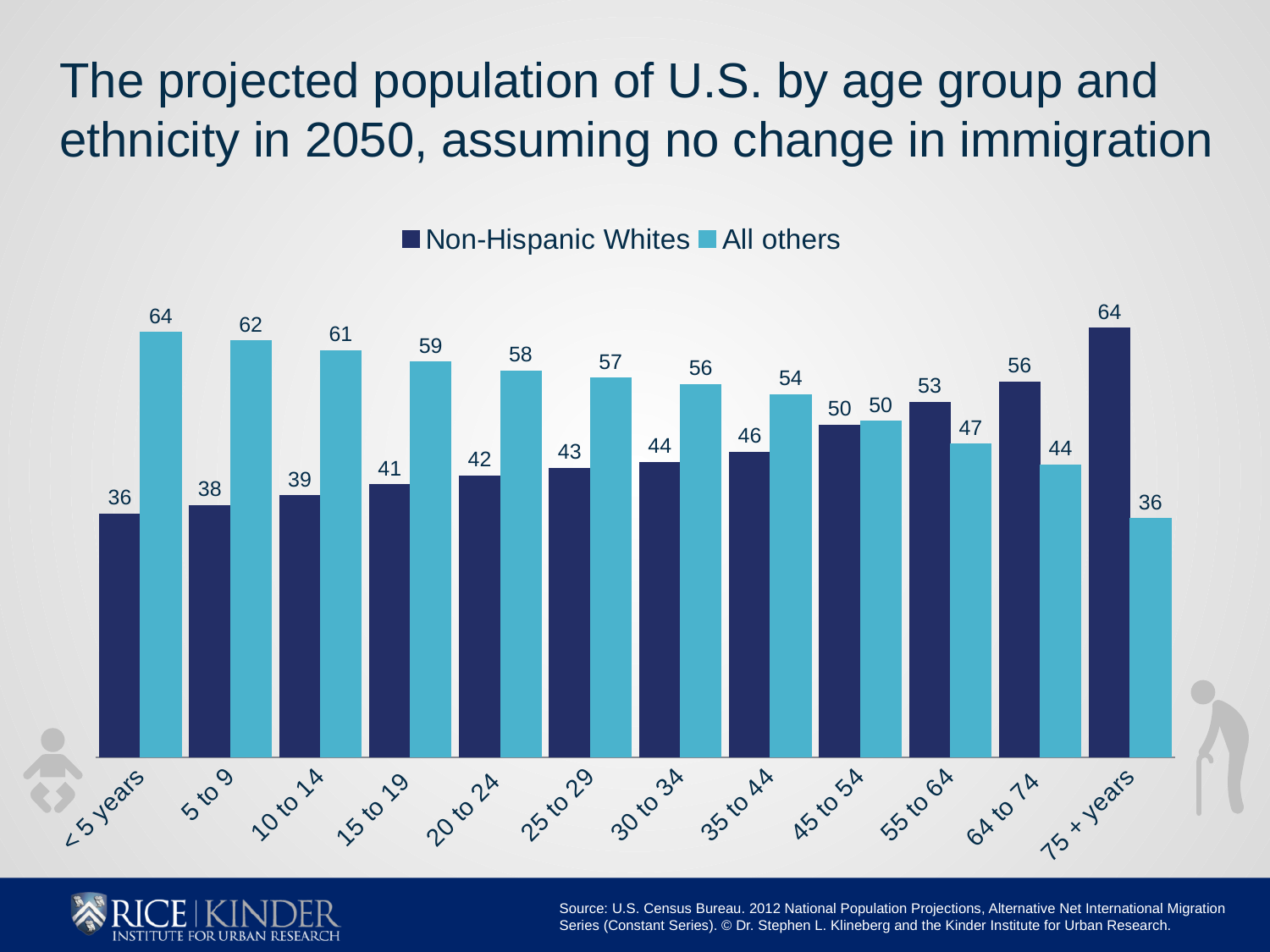
What is the value for Non-Hispanic Whites in the 55 to 64 age group? 53 What is the value for Non-Hispanic Whites in the < 5 years age group? 36 What is the value for All others in the 25 to 29 age group? 57 Which age group has the lowest value for All others? 75 + years How many series does the legend list? 2 Do the values for Non-Hispanic Whites rise or fall as age group increases along the x axis? Rise Which age group has the highest value for Non-Hispanic Whites? 75 + years What kind of chart is shown on the slide? Bar chart How many age groups are shown on the x axis? 12 What colour are the bars for All others? Light blue What is the difference between All others and Non-Hispanic Whites in the 5 to 9 age group? 24 In the 64 to 74 age group, which series has the larger value, Non-Hispanic Whites or All others? Non-Hispanic Whites